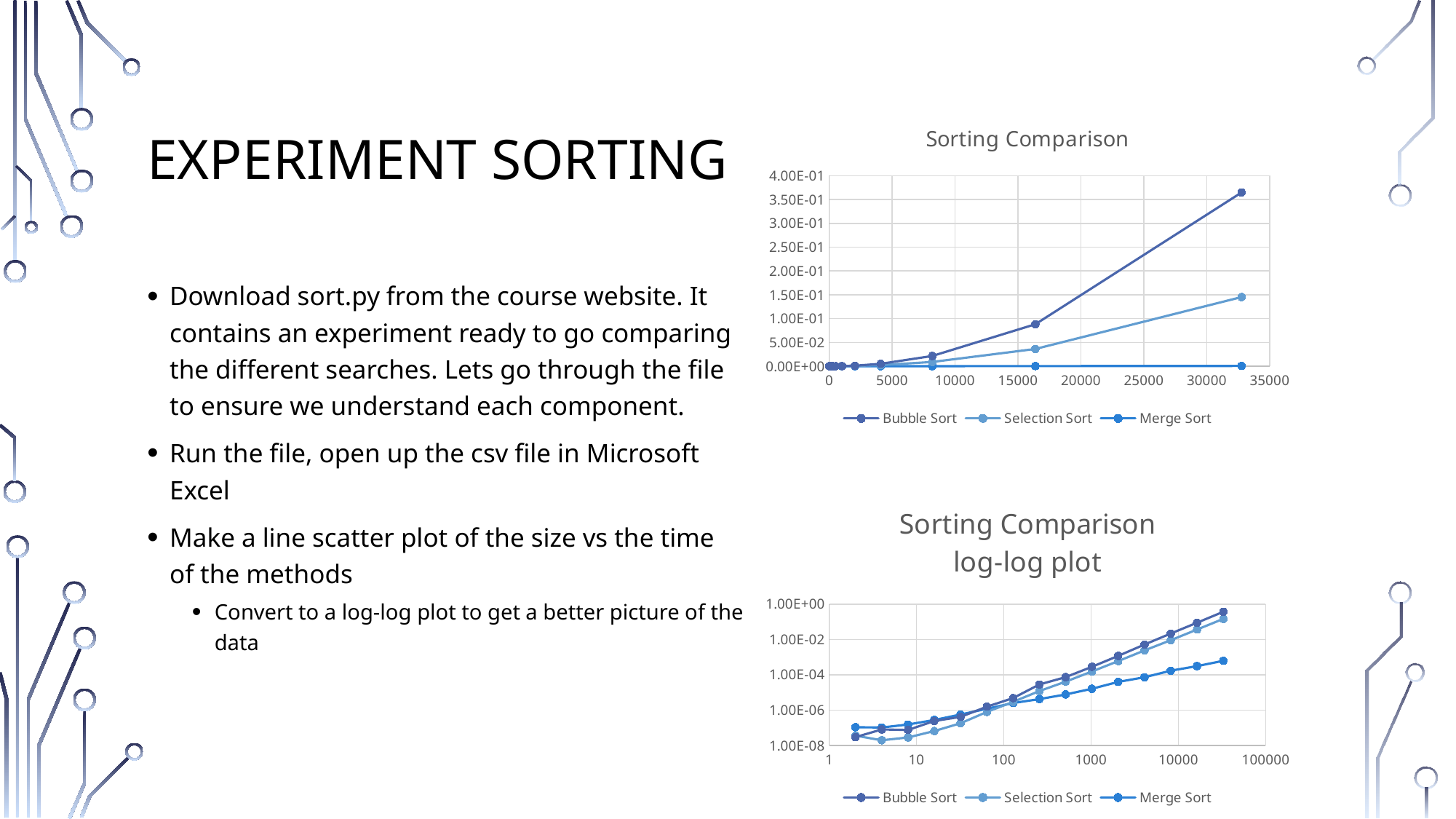
In the top "Sorting Comparison" chart, is the Merge Sort value at the largest input size greater or less than 5.00E-02? less In the top "Sorting Comparison" chart, which is larger at the largest input size: Bubble Sort or Selection Sort? Bubble Sort What kind of chart is the top chart titled "Sorting Comparison"? line chart How many series does the legend of the top "Sorting Comparison" chart list? 3 In the top "Sorting Comparison" chart, which series has the highest value at the largest input size? Bubble Sort In the bottom "Sorting Comparison log-log plot" chart, is the Bubble Sort value at the largest input size greater or less than 1.00E+00? less In the bottom "Sorting Comparison log-log plot" chart, is the Merge Sort value at the largest input size greater or less than 1.00E-04? greater In the top "Sorting Comparison" chart, do the Bubble Sort values rise or fall as the input size increases? rise What is the title of the bottom chart? Sorting Comparison log-log plot In the top "Sorting Comparison" chart, which series has the lowest value at the largest input size? Merge Sort